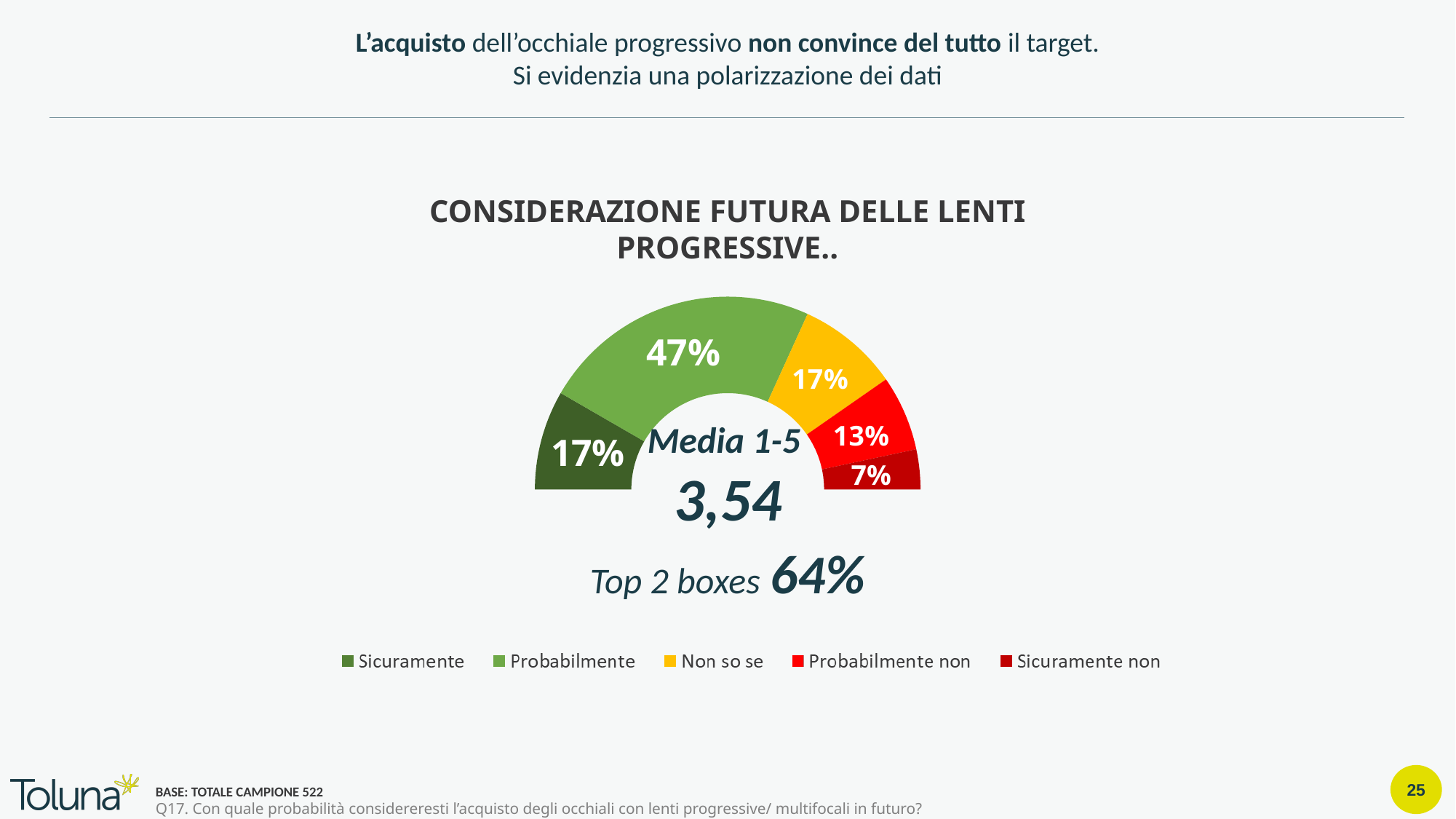
Which response category has the smallest share? Sicuramente non What percentage of respondents answered "Probabilmente"? 47% Which response category has the largest share? Probabilmente What percentage of respondents answered "Non so se"? 17% What is the difference in percentage points between "Probabilmente" and "Sicuramente"? 30 Which is larger, the share for "Probabilmente non" or the share for "Sicuramente non"? Probabilmente non What is the "Top 2 boxes" value shown below the chart? 64% What percentage of respondents answered "Probabilmente non"? 13% What is the "Media 1-5" value shown in the centre of the chart? 3,54 What percentage of respondents answered "Sicuramente non"? 7% How many response categories does the legend list? 5 What kind of chart is shown on the slide? Doughnut chart (semi-circular)